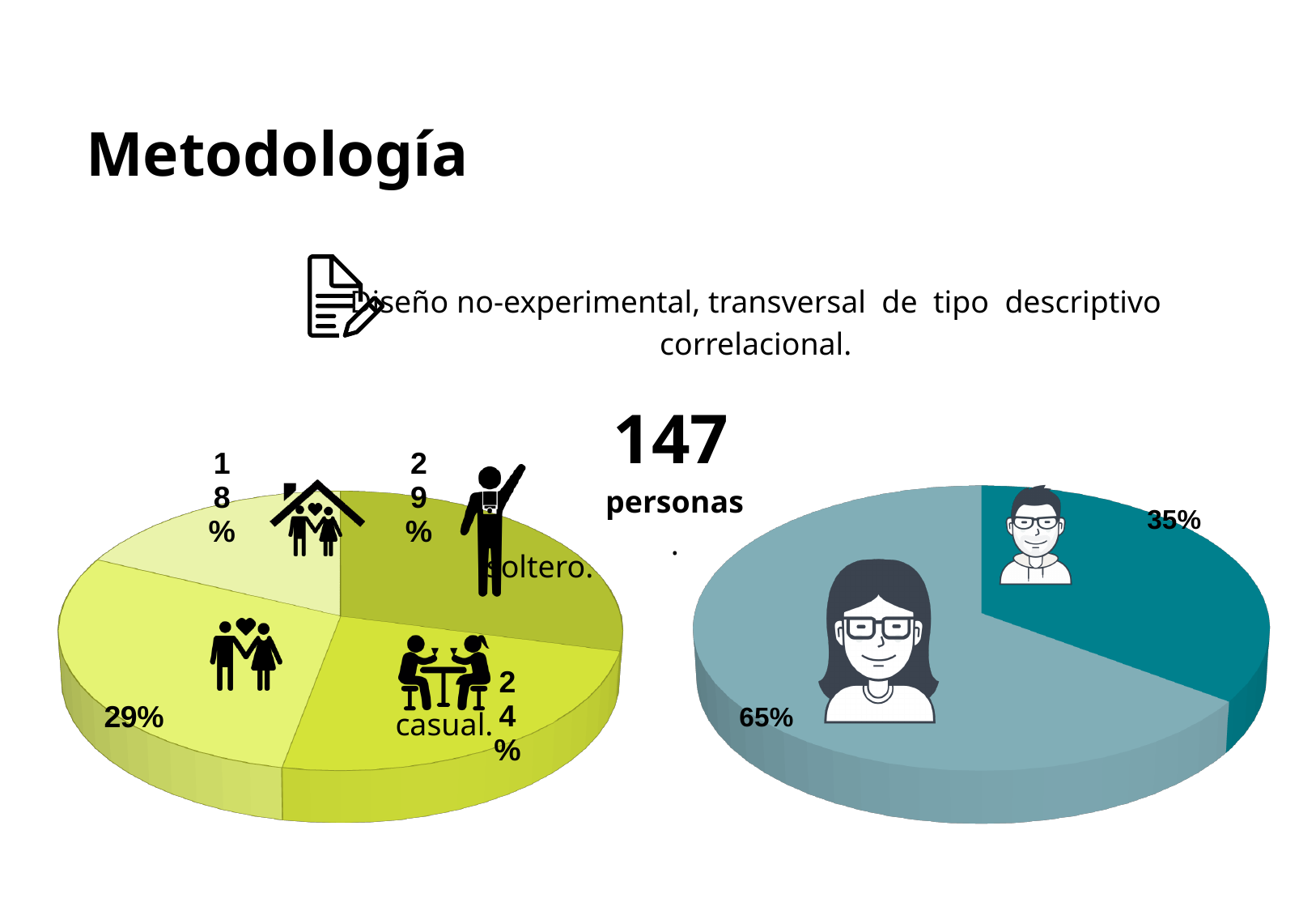
In the right pie chart, what is the largest percentage shown? 65% What is the smallest percentage shown on the left pie chart? 18% What kind of chart is the chart on the left side of the slide? pie chart How many slices does the right pie chart have? 2 What kind of chart is the chart on the right side of the slide? pie chart In the left pie chart, what percentage is shown for the slice labelled "casual"? 24% In the right pie chart, what percentage is shown for the dark teal slice? 35% In the left pie chart, which slice is larger, "soltero" or "casual"? soltero In the right pie chart, what is the difference in percentage points between the two slices? 30 percentage points How many slices does the left pie chart have? 4 In the left pie chart, what is the difference in percentage points between the "soltero" slice and the "casual" slice? 5 percentage points In the left pie chart, what percentage is shown for the slice labelled "soltero"? 29%